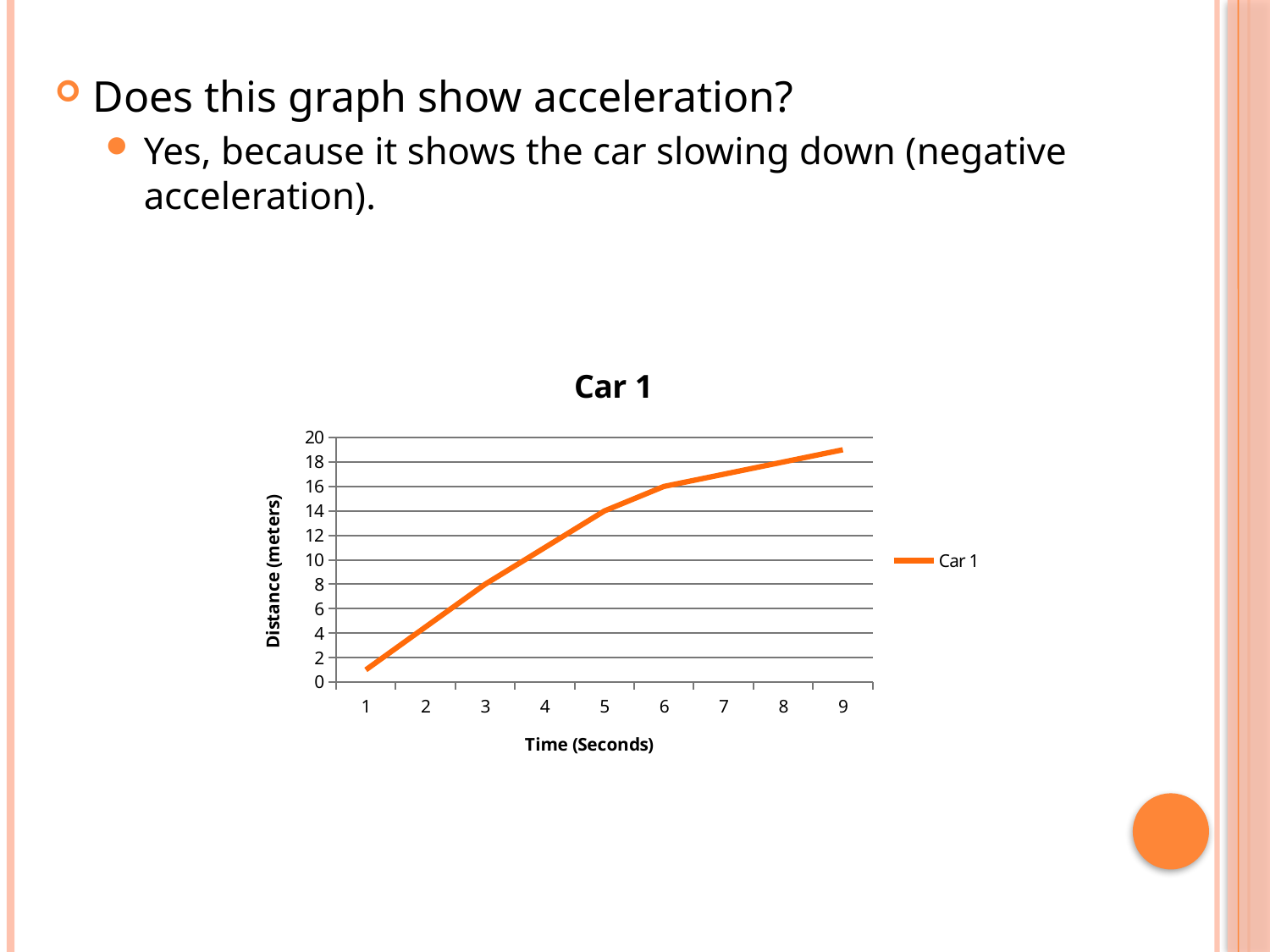
How many time points are plotted along the x axis? 9 At which time (seconds) is the distance highest? 9 Is the distance at 2 seconds greater or less than 6 meters? less What kind of chart is shown on the slide? line chart Is the distance at 3 seconds greater or less than 10 meters? less What is the title of the chart? Car 1 At which time (seconds) is the distance lowest? 1 Does the distance rise or fall as time increases along the x axis? rise How many series does the legend list? 1 What is the label on the vertical axis? Distance (meters) Is the distance at 7 seconds greater or less than 16 meters? greater Which is larger, the distance at 4 seconds or the distance at 8 seconds? 8 seconds